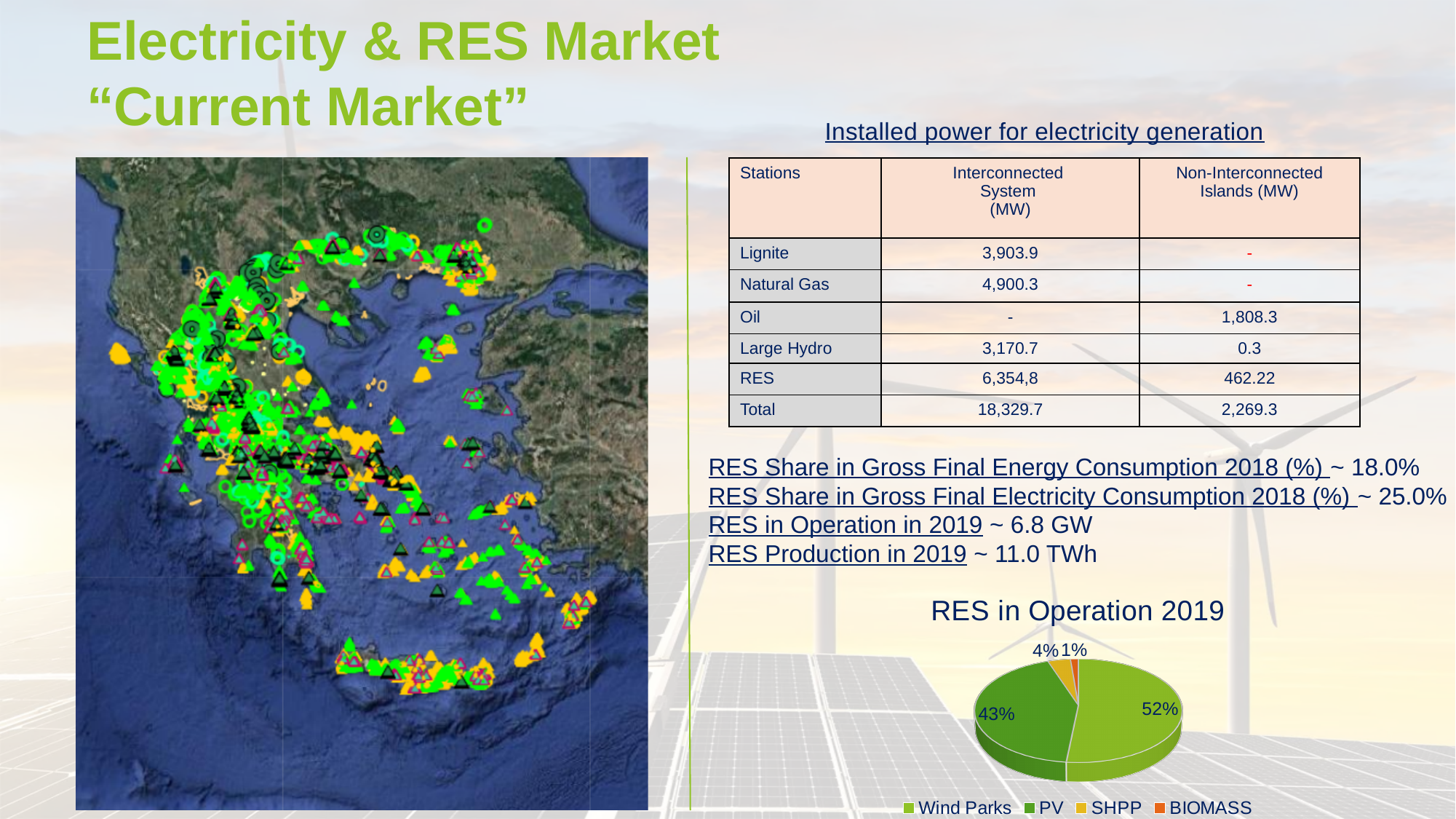
In the "RES in Operation 2019" pie chart, what share does BIOMASS have? 1% Which category has the largest slice in the "RES in Operation 2019" pie chart? Wind Parks In the "RES in Operation 2019" pie chart, what is the combined share of SHPP and BIOMASS? 5% In the "RES in Operation 2019" pie chart, what share do Wind Parks have? 52% What is the title of the pie chart on the slide? RES in Operation 2019 In the "RES in Operation 2019" pie chart, what is the difference in percentage points between Wind Parks and PV? 9 What kind of chart is shown under the title "RES in Operation 2019"? pie chart Which category has the smallest slice in the "RES in Operation 2019" pie chart? BIOMASS In the "RES in Operation 2019" pie chart, what share does SHPP have? 4% How many categories does the legend of the "RES in Operation 2019" pie chart list? 4 In the "RES in Operation 2019" pie chart, which is larger, the SHPP slice or the BIOMASS slice? SHPP